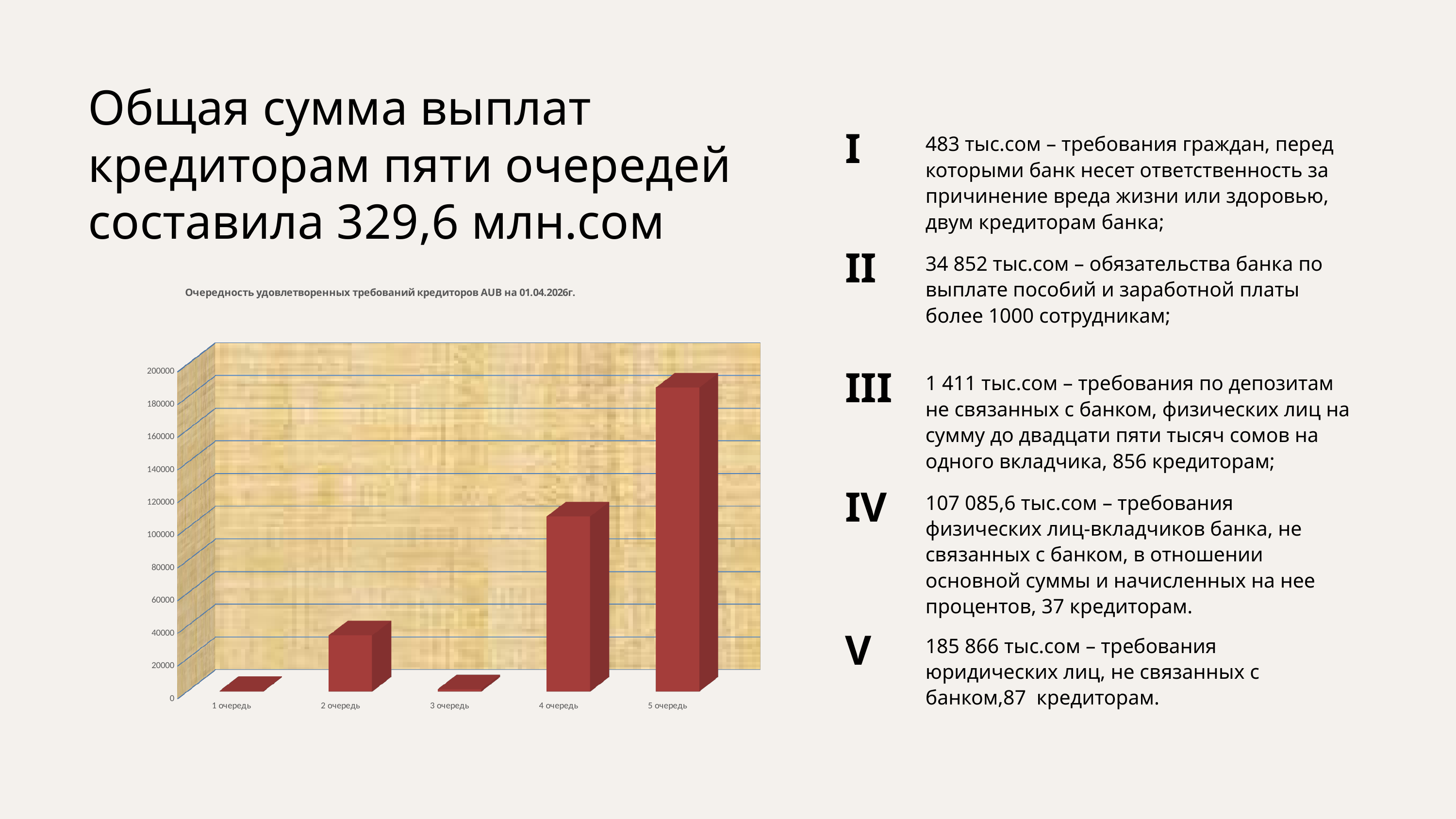
How many categories (очереди) are shown on the x axis of the chart? 5 Is the value for 3 очередь greater or less than 20000? less Is the value for 2 очередь greater or less than 20000? greater Is the value for 2 очередь greater or less than 60000? less Does the value rise or fall from 4 очередь to 5 очередь? rise What is the title of the chart? Очередность удовлетворенных требований кредиторов AUB на 01.04.2026г. Which is larger, the value for 5 очередь or the value for 4 очередь? 5 очередь What kind of chart is shown on the slide? bar chart Which category has the highest bar in the chart? 5 очередь Which is larger, the value for 4 очередь or the value for 2 очередь? 4 очередь